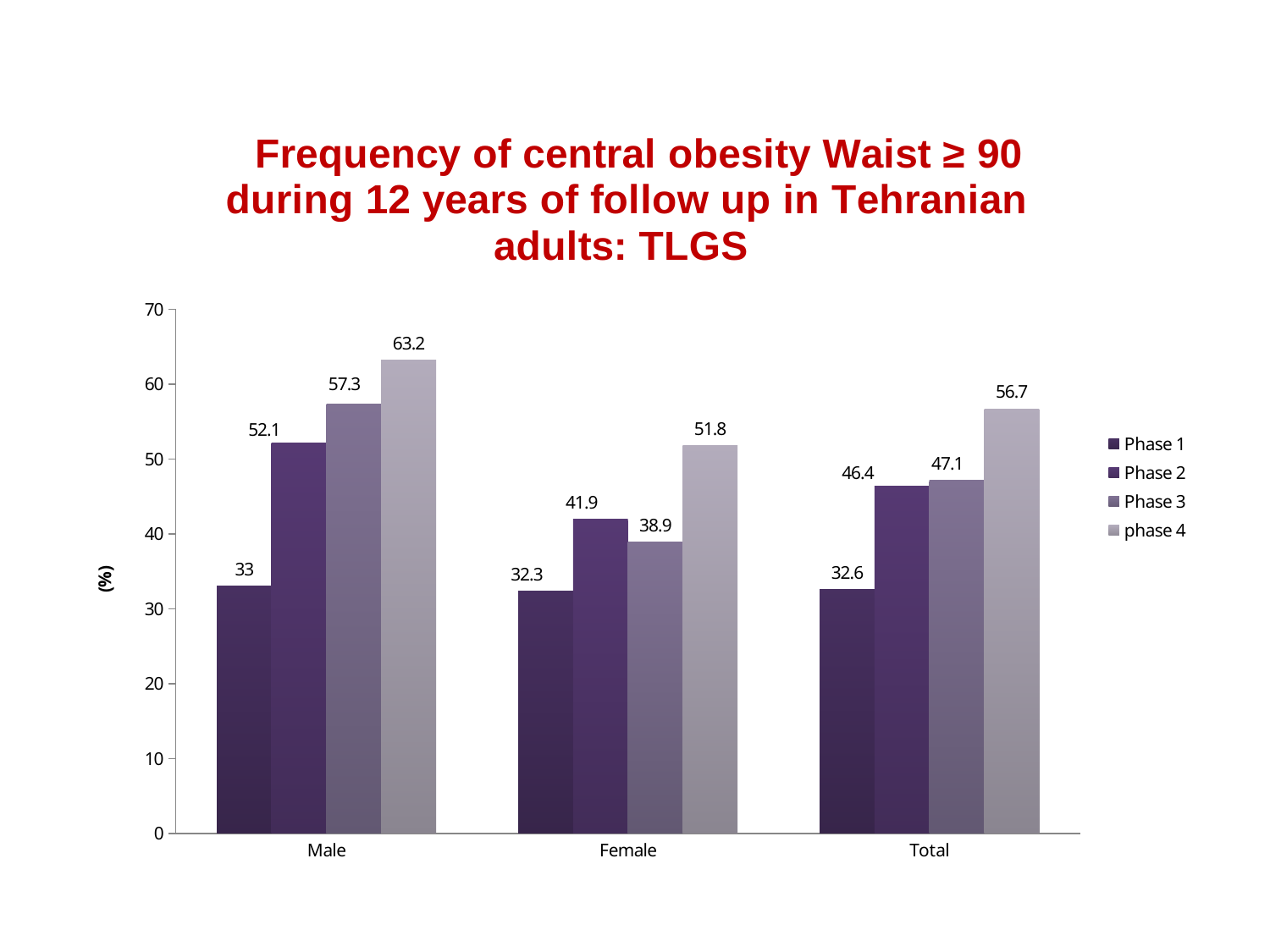
What is the Phase 3 value for Total? 47.1 What is the phase 4 value for Female? 51.8 Which is larger for Female: the Phase 2 value or the Phase 3 value? Phase 2 What is the label on the vertical axis? (%) What is the Phase 1 value for Male? 33 Is the Phase 2 value for Total greater or less than 40? greater How many series does the legend list? 4 How many categories are shown on the x axis? 3 What is the difference between the phase 4 and Phase 1 values for Male? 30.2 Which category has the lowest Phase 2 value? Female What kind of chart is shown on the slide? bar chart Which category has the highest phase 4 value? Male